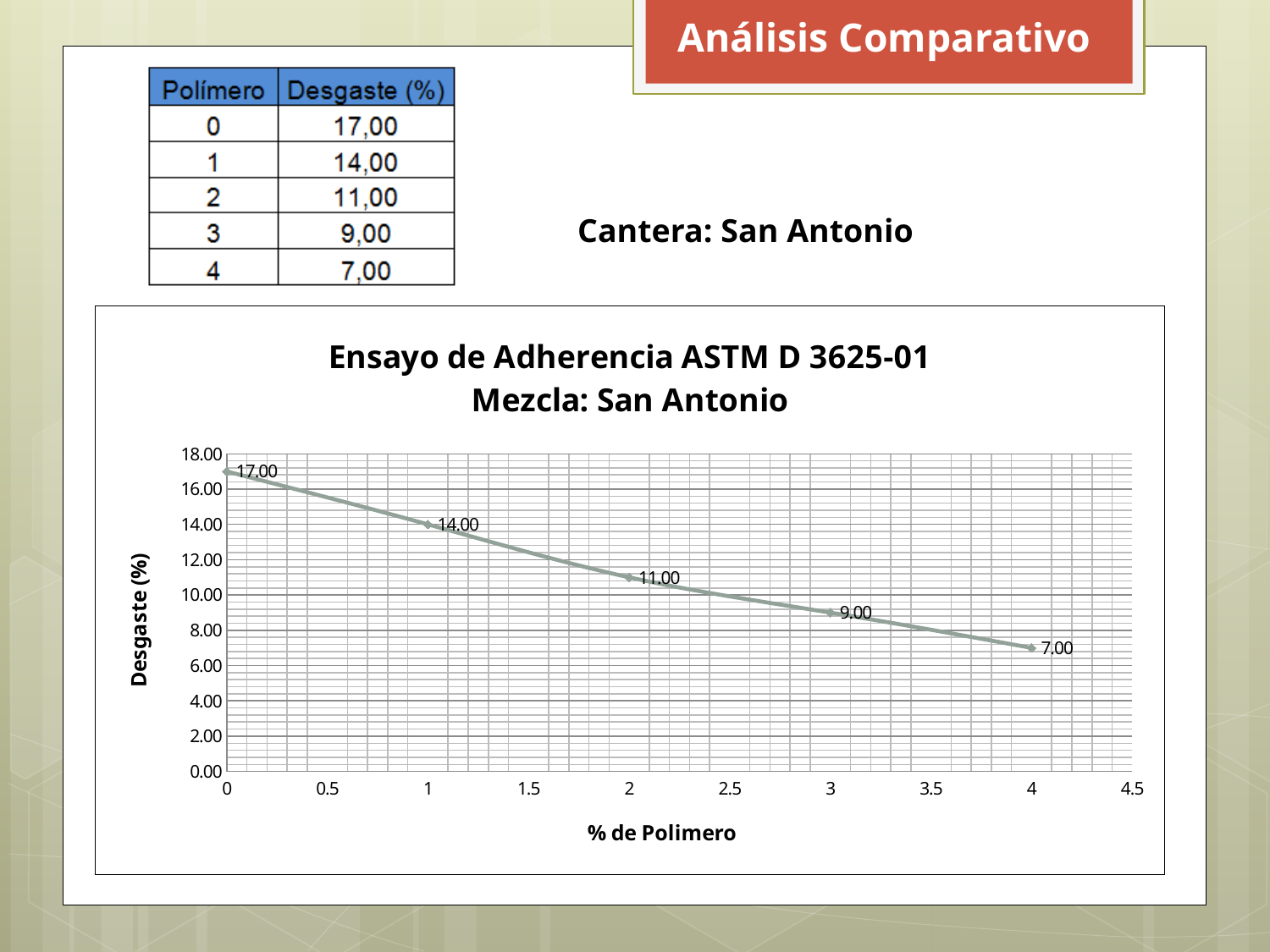
At which % de Polimero is Desgaste (%) lowest? 4 Is the Desgaste (%) value at 3% de Polimero greater or less than 10.00? less What is the difference in Desgaste (%) between 0% and 4% de Polimero? 10.00 What is the Desgaste (%) value at 2% de Polimero? 11.00 How many data points are plotted on the chart? 5 What is the difference in Desgaste (%) between 1% and 3% de Polimero? 5.00 At which % de Polimero is Desgaste (%) highest? 0 Which has a higher Desgaste (%): 1% de Polimero or 3% de Polimero? 1% de Polimero What is the Desgaste (%) value at 0% de Polimero? 17.00 What is the Desgaste (%) value at 4% de Polimero? 7.00 Does Desgaste (%) rise or fall as % de Polimero increases? fall What kind of chart is shown on the slide? line chart